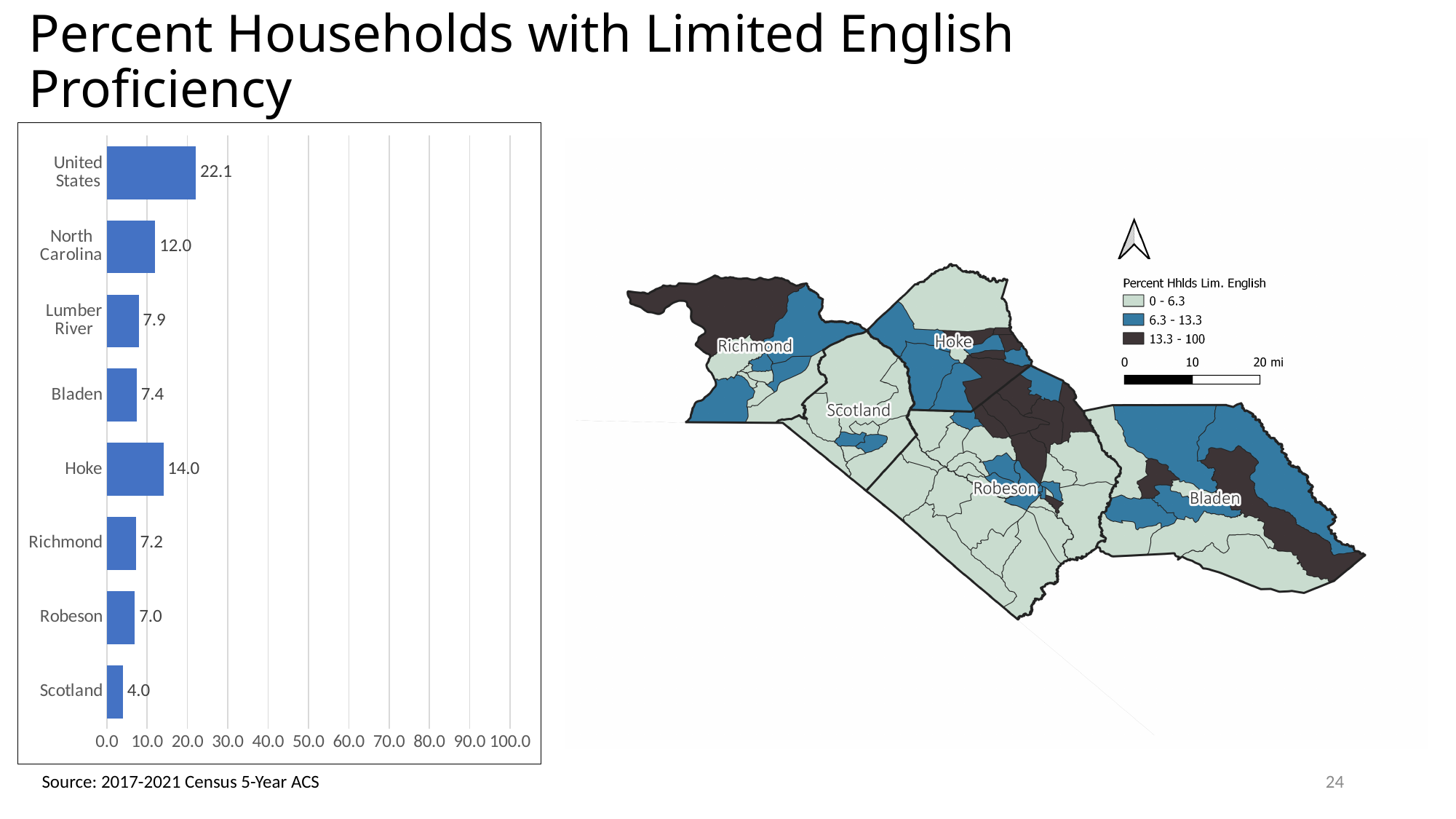
In the bar chart, is the value for United States greater or less than 20.0? greater In the bar chart, which category has the highest value? United States In the bar chart, what is the difference between the values for United States and North Carolina? 10.1 In the bar chart, what is the value for North Carolina? 12.0 In the bar chart, what is the value for Hoke? 14.0 In the bar chart, which is larger, the value for Hoke or the value for Lumber River? Hoke What kind of chart is shown on the left of the slide? bar chart In the bar chart, what is the value for Scotland? 4.0 In the bar chart, what is the difference between the values for Hoke and Scotland? 10.0 In the bar chart, which category has the lowest value? Scotland What is the maximum value shown on the x axis of the bar chart? 100.0 How many categories are shown in the bar chart? 8